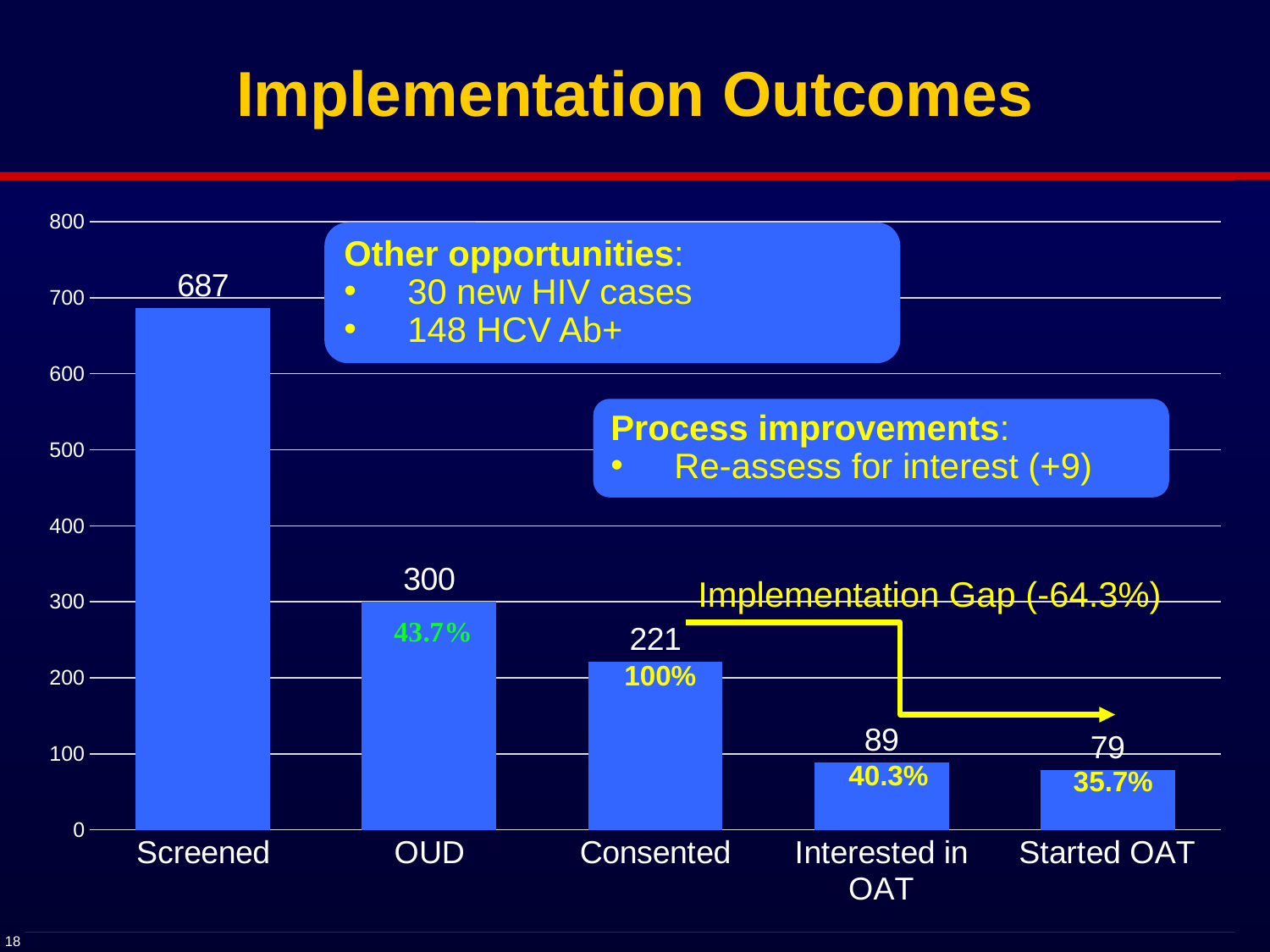
What is the value for Consented? 221 How many categories are shown on the x axis? 5 What is the difference between the values for Consented and Started OAT? 142 What is the value for Interested in OAT? 89 What is the value for Screened? 687 Which is larger, the value for OUD or the value for Consented? OUD Which category has the lowest value? Started OAT What kind of chart is shown on the slide? Bar chart What is the value for Started OAT? 79 What is the value for OUD? 300 What percentage label is shown inside the Interested in OAT bar? 40.3% Which category has the highest value? Screened